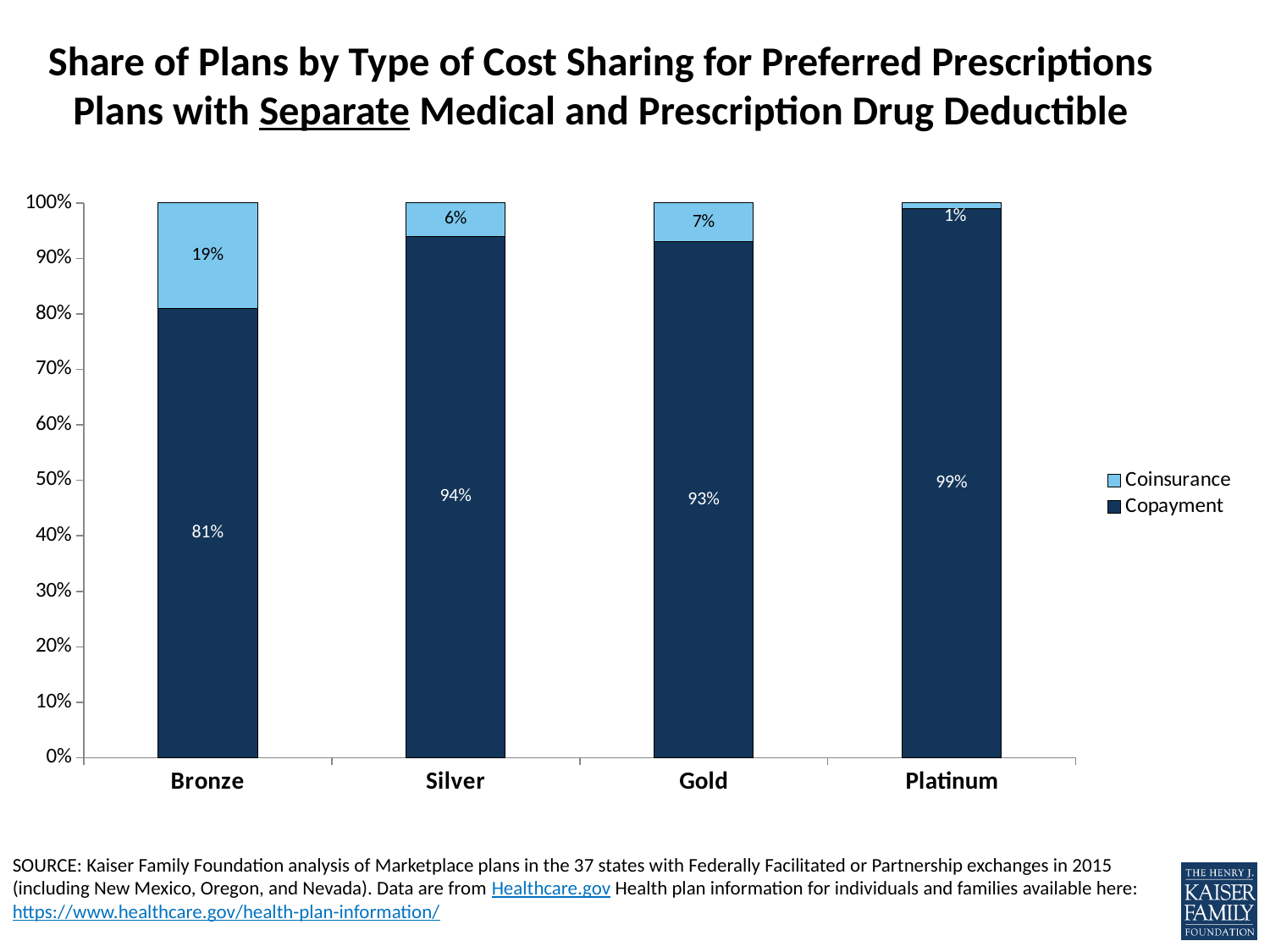
What kind of chart is shown on the slide? Stacked bar chart Which plan type has the highest Coinsurance share? Bronze What is the difference between the Copayment shares for Platinum and Bronze plans? 18% Which plan type has the lowest Copayment share? Bronze What is the Copayment share for Platinum plans? 99% How many series does the legend list? 2 What is the Coinsurance share for Silver plans? 6% How many plan types are shown on the x axis? 4 Which is larger, the Copayment share for Silver or for Gold? Silver What is the Copayment share for Bronze plans? 81% Does the Copayment share rise or fall from Bronze to Platinum? Rise What is the Coinsurance share for Gold plans? 7%